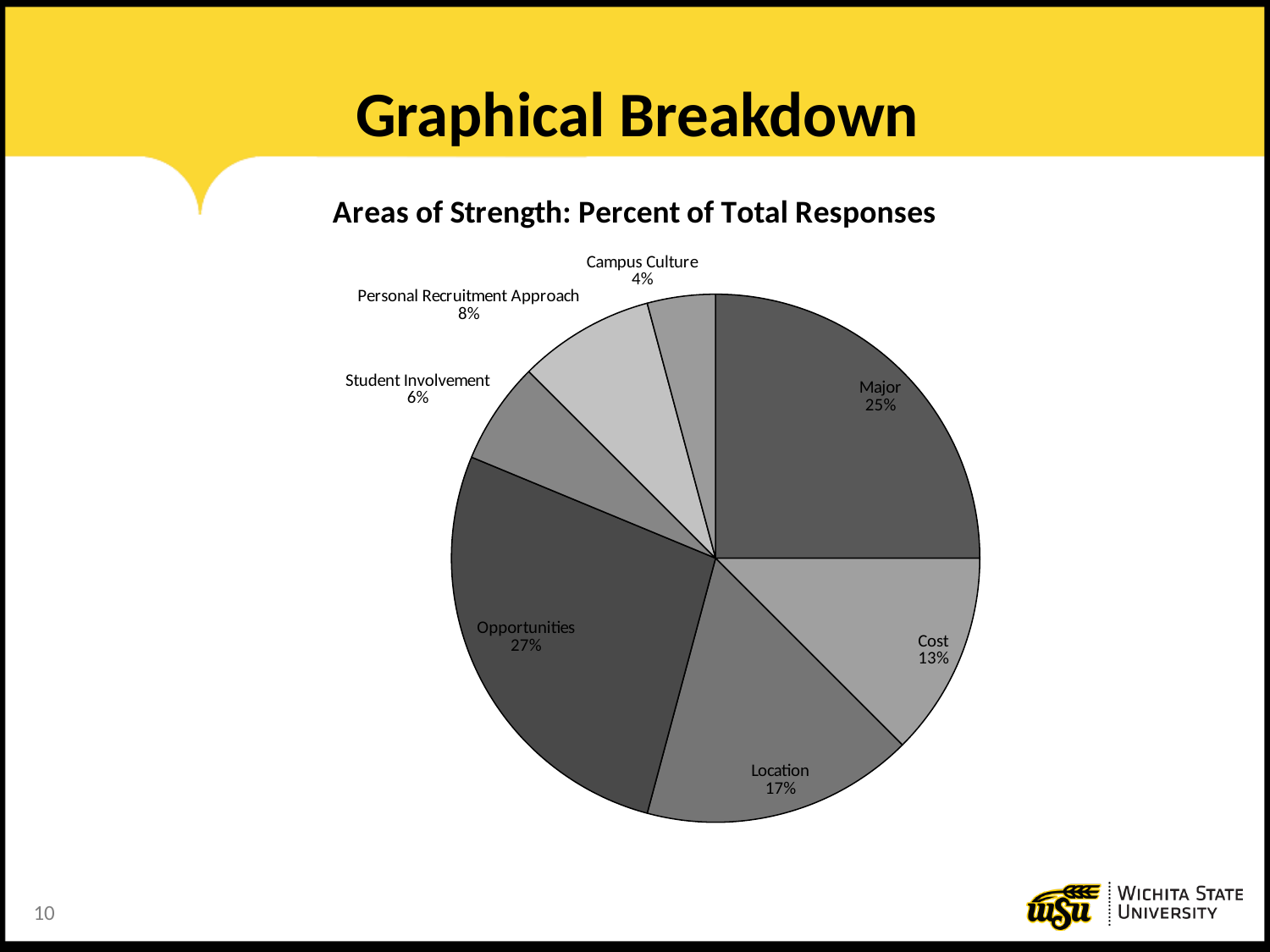
Which is larger, Student Involvement or Campus Culture? Student Involvement Which category has the largest share of total responses? Opportunities What is the difference in percentage points between Opportunities and Cost? 14 What is the title of the chart? Areas of Strength: Percent of Total Responses How many categories are shown in the pie chart? 7 What percentage of total responses is Major? 25% Which category has the smallest share of total responses? Campus Culture What percentage of total responses is Personal Recruitment Approach? 8% What kind of chart is shown on the slide? Pie chart What share of the pie does Cost represent? 13% What is the difference in percentage points between Major and Location? 8 What percentage of total responses is Location? 17%